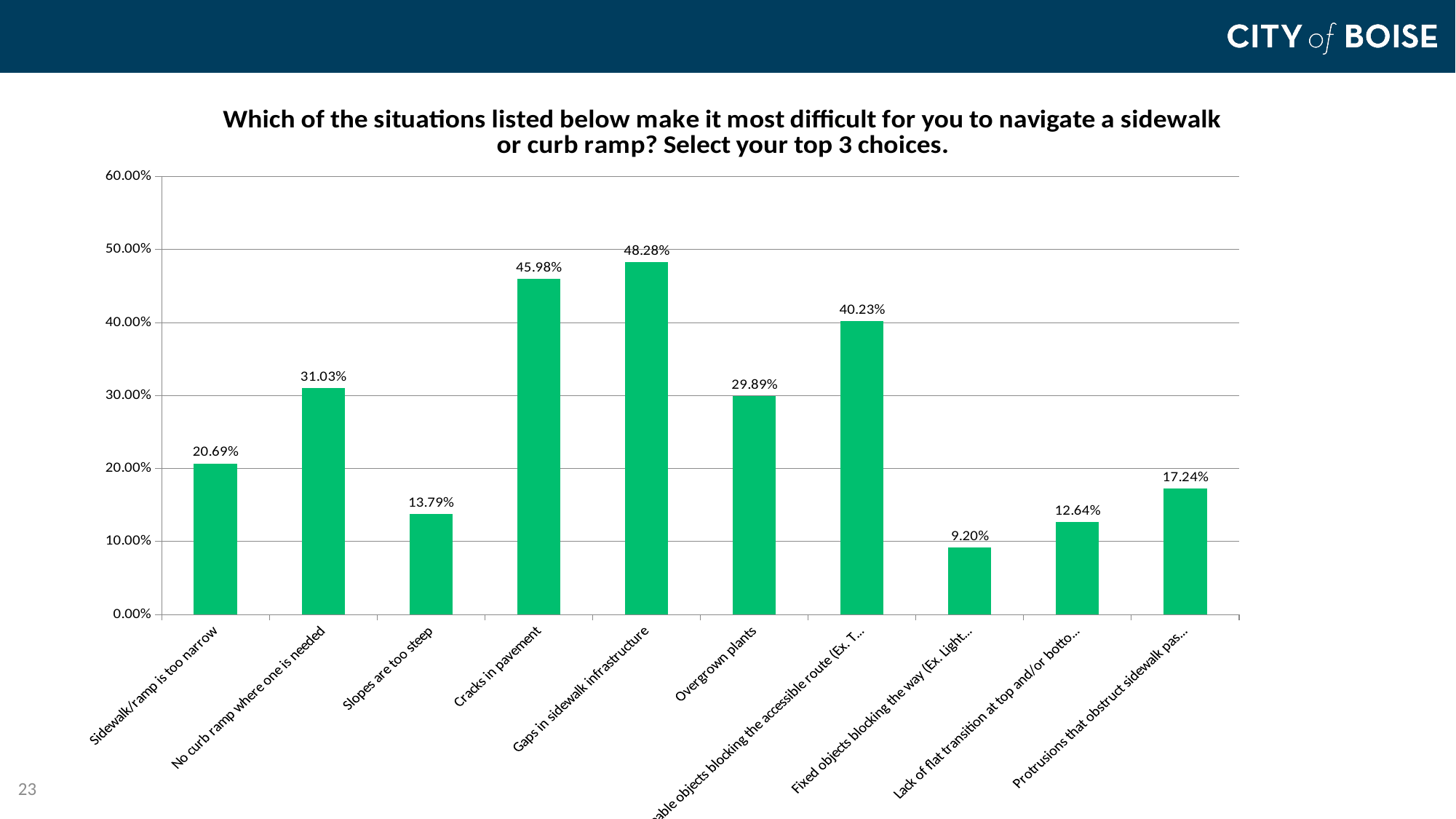
Which situation has the highest percentage? Gaps in sidewalk infrastructure What is the value for "No curb ramp where one is needed"? 31.03% What is the value for "Slopes are too steep"? 13.79% What percentage of respondents selected "Cracks in pavement"? 45.98% Which situation has the lowest percentage? Fixed objects blocking the way What is the difference between the values for "Gaps in sidewalk infrastructure" and "Cracks in pavement"? 2.30% What is the highest value shown on the vertical axis? 60.00% Is the value for "Overgrown plants" greater or less than 30.00%? less What is the value for "Overgrown plants"? 29.89% Which is larger: the value for "Sidewalk/ramp is too narrow" or the value for "Slopes are too steep"? Sidewalk/ramp is too narrow How many situations (bars) are shown in the chart? 10 What kind of chart is shown on the slide? Bar chart